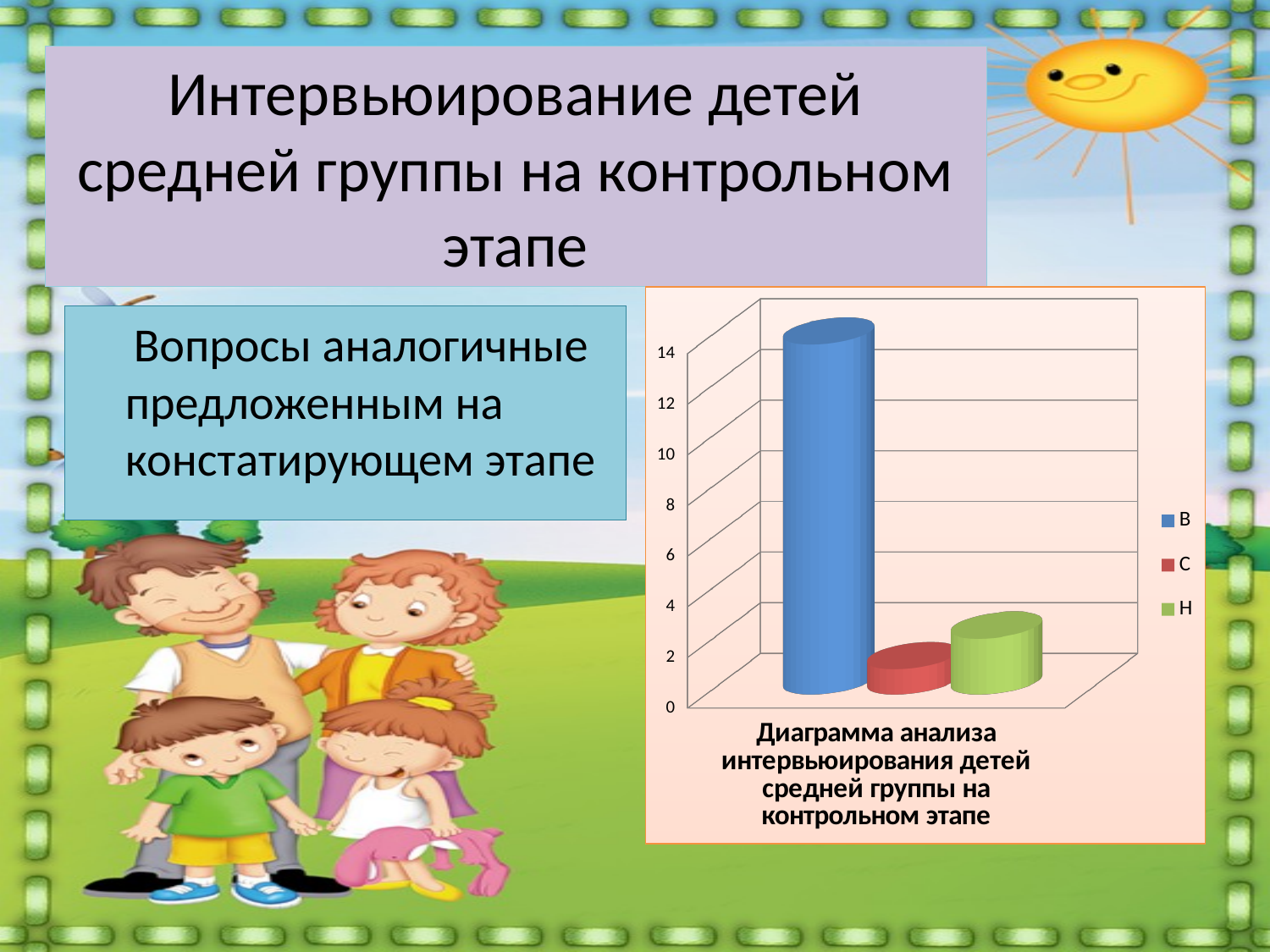
Is the value for В greater or less than 10? greater How many series does the chart legend list? 3 Is the value for Н greater or less than 6? less How many bars are plotted in the chart? 3 What kind of chart is shown on the slide? bar chart Which is larger in the chart, the value for В or the value for Н? В Which is larger in the chart, the value for Н or the value for С? Н What are the legend entries of the chart, in order from top to bottom? В, С, Н Which series has the lowest bar in the chart? С Which series has the highest bar in the chart? В Is the value for С greater or less than 4? less What colour is the bar for series В in the chart? blue